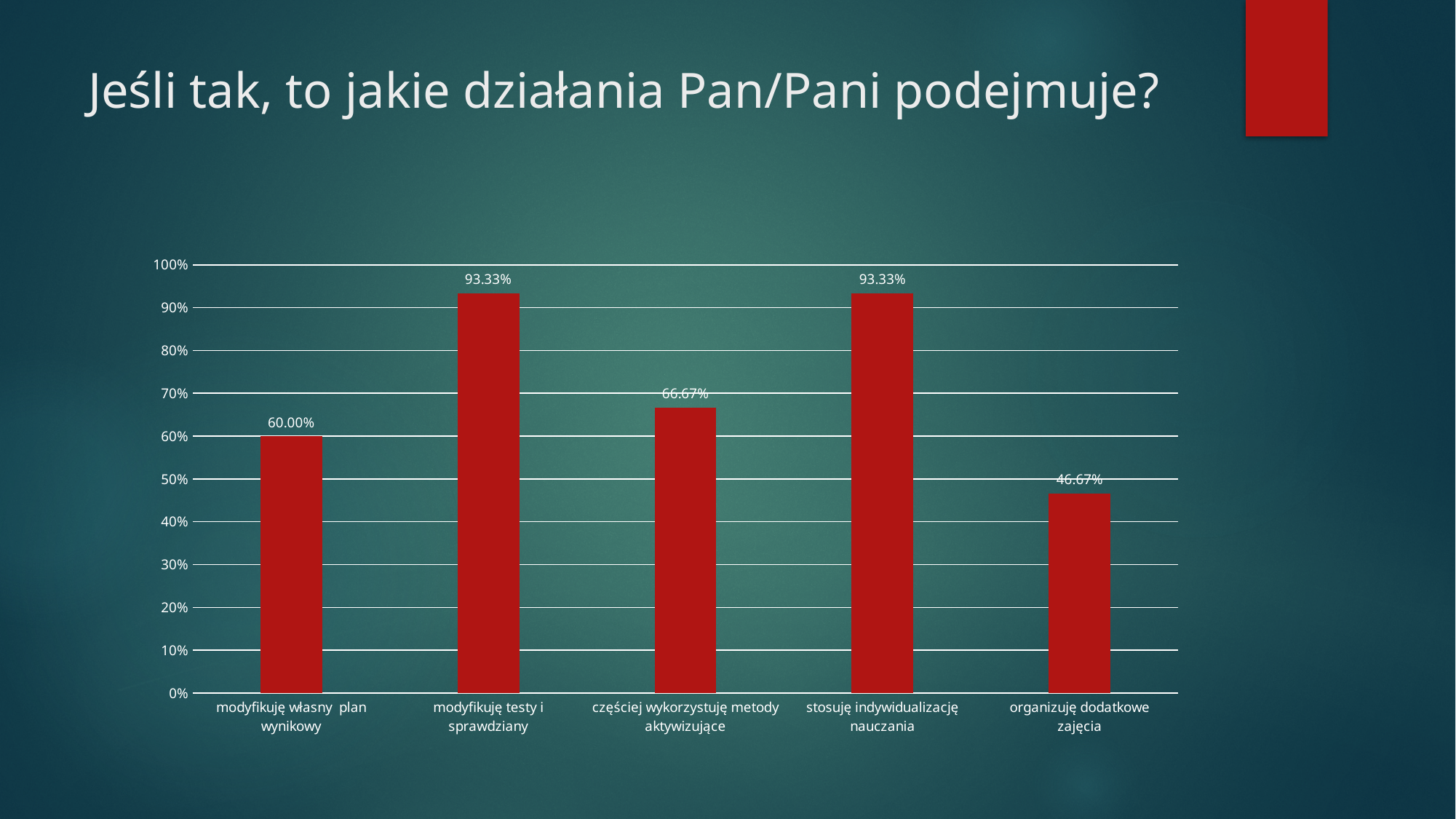
What is the difference between the values for 'stosuję indywidualizację nauczania' and 'organizuję dodatkowe zajęcia'? 46.66% Which is larger: the value for 'częściej wykorzystuję metody aktywizujące' or for 'modyfikuję własny plan wynikowy'? częściej wykorzystuję metody aktywizujące What kind of chart is shown on the slide? bar chart Is the value for 'organizuję dodatkowe zajęcia' greater or less than 50%? less What is the value for 'modyfikuję własny plan wynikowy'? 60.00% What is the value for 'częściej wykorzystuję metody aktywizujące'? 66.67% How many categories are shown on the chart? 5 What is the title of the slide? Jeśli tak, to jakie działania Pan/Pani podejmuje? Which categories share the highest value? modyfikuję testy i sprawdziany and stosuję indywidualizację nauczania Which category has the lowest value? organizuję dodatkowe zajęcia What is the value for 'organizuję dodatkowe zajęcia'? 46.67% What is the value for 'modyfikuję testy i sprawdziany'? 93.33%